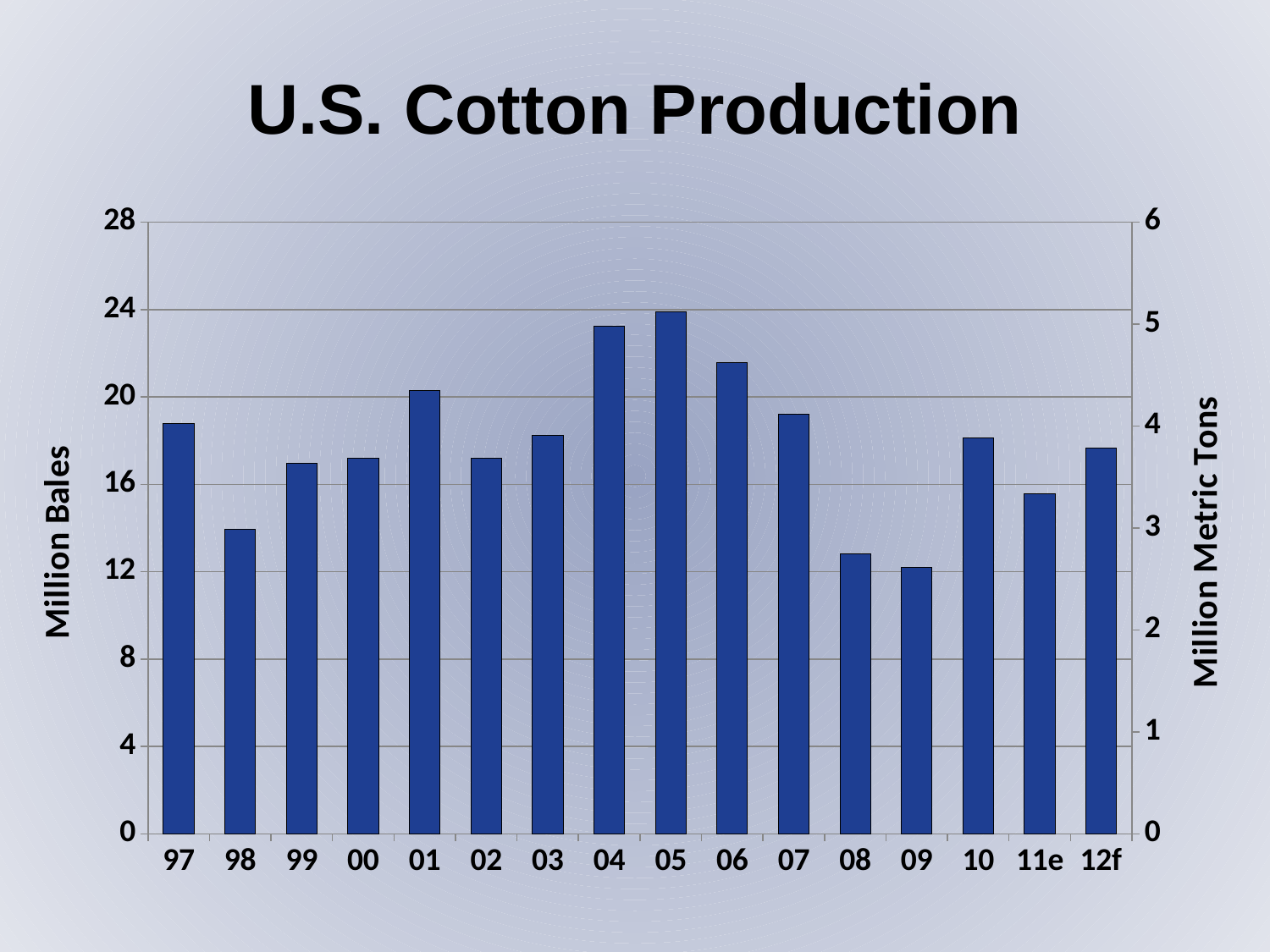
Which year has the larger value, 04 or 06? 04 What is the label of the left vertical axis? Million Bales Which year has the highest cotton production? 05 Is the value for 97 greater or less than 16 million bales? greater Is the value for 04 greater or less than 20 million bales? greater What is the title of the chart? U.S. Cotton Production Is the value for 08 greater or less than 16 million bales? less What kind of chart is shown on the slide? bar chart Which year has the lowest cotton production? 09 How many years (bars) are shown on the x axis? 16 Which year has the larger value, 98 or 99? 99